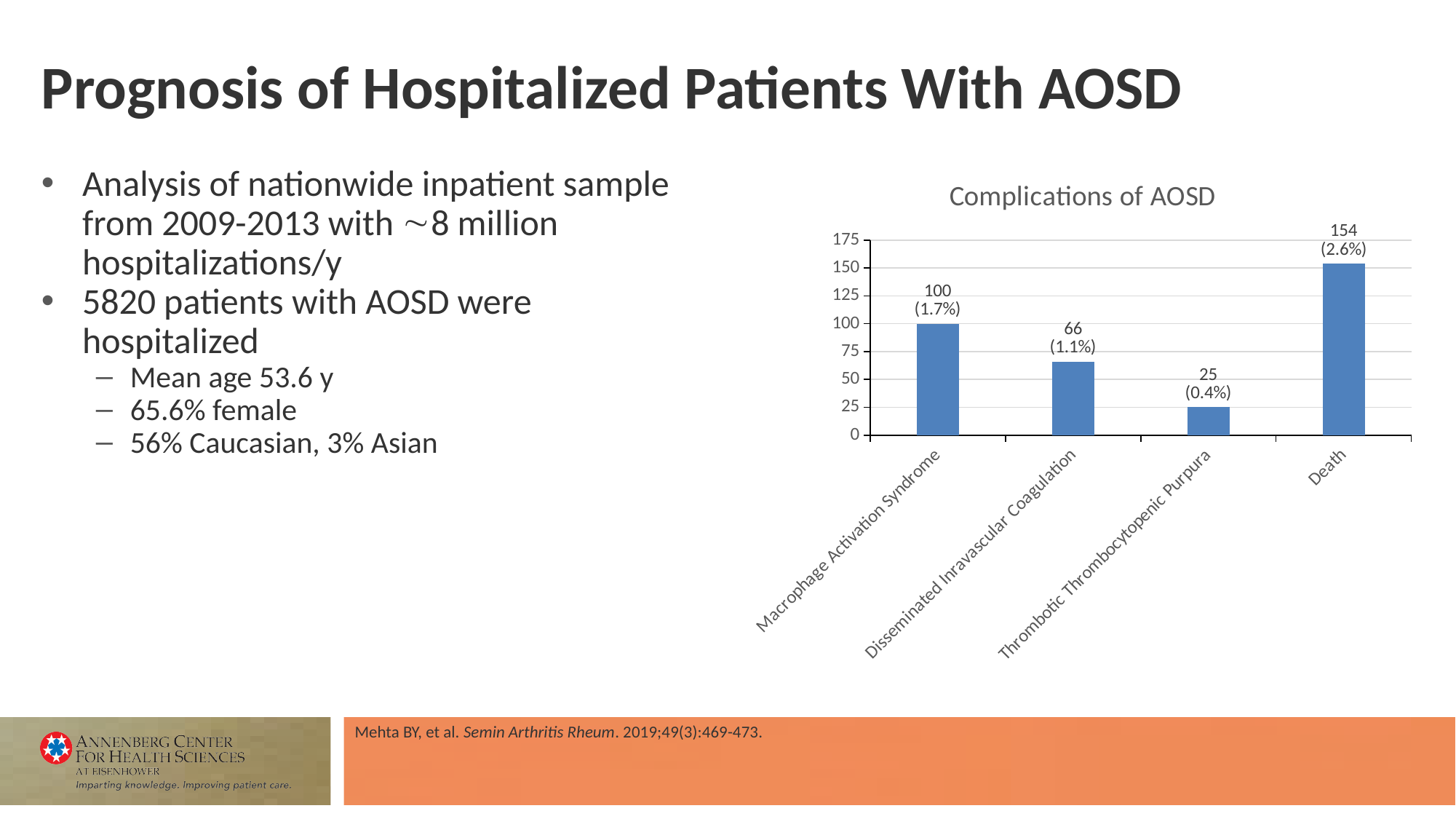
Which complication has the highest value? Death Which is larger, the value for Macrophage Activation Syndrome or Disseminated Intravascular Coagulation? Macrophage Activation Syndrome What is the difference between the counts for Death and Macrophage Activation Syndrome? 54 What is the value for Thrombotic Thrombocytopenic Purpura? 25 (0.4%) How many complication categories are shown in the chart? 4 Which complication has the lowest value? Thrombotic Thrombocytopenic Purpura What is the title of the chart? Complications of AOSD What is the difference between the counts for Disseminated Intravascular Coagulation and Thrombotic Thrombocytopenic Purpura? 41 What is the value for Death in the Complications of AOSD chart? 154 (2.6%) What is the value for Macrophage Activation Syndrome? 100 (1.7%) What is the value for Disseminated Intravascular Coagulation? 66 (1.1%) What kind of chart is shown on the slide? Bar chart